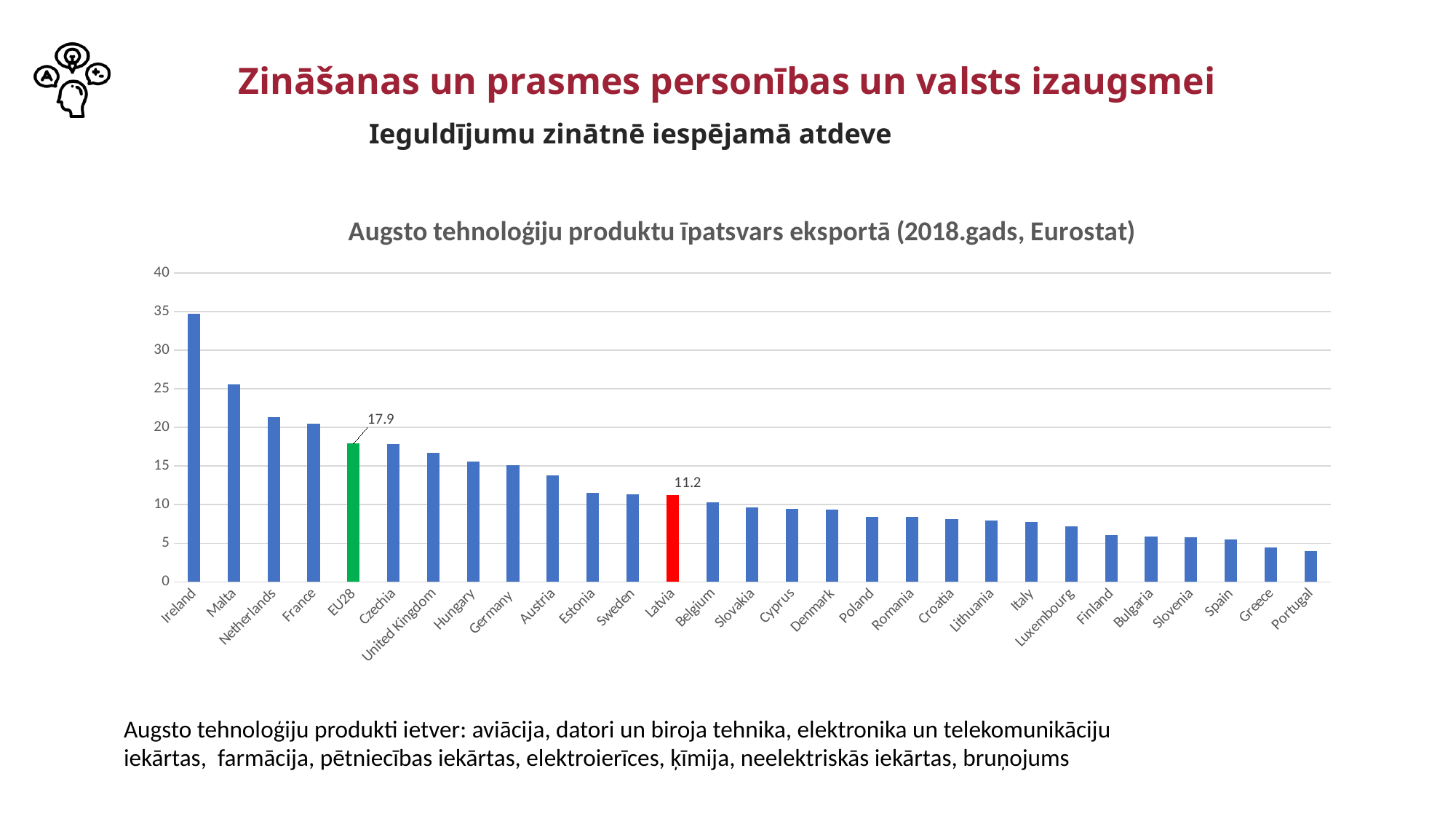
Which country has the highest share of high-tech products in exports? Ireland What is the difference between the EU28 value and the Latvia value? 6.7 What kind of chart is shown on the slide? Bar chart Is the value for Portugal greater or less than 5? less Which country has the lowest value in the chart? Portugal Which is larger, the value for France or the value for Germany? France Is the value for Ireland greater or less than 30? greater Do the values rise or fall from left to right along the x axis? Fall How many bars (categories) are shown in the chart? 29 Which is larger, the value for EU28 or the value for Latvia? EU28 What is the value for EU28 in the chart? 17.9 What is the value for Latvia in the chart? 11.2